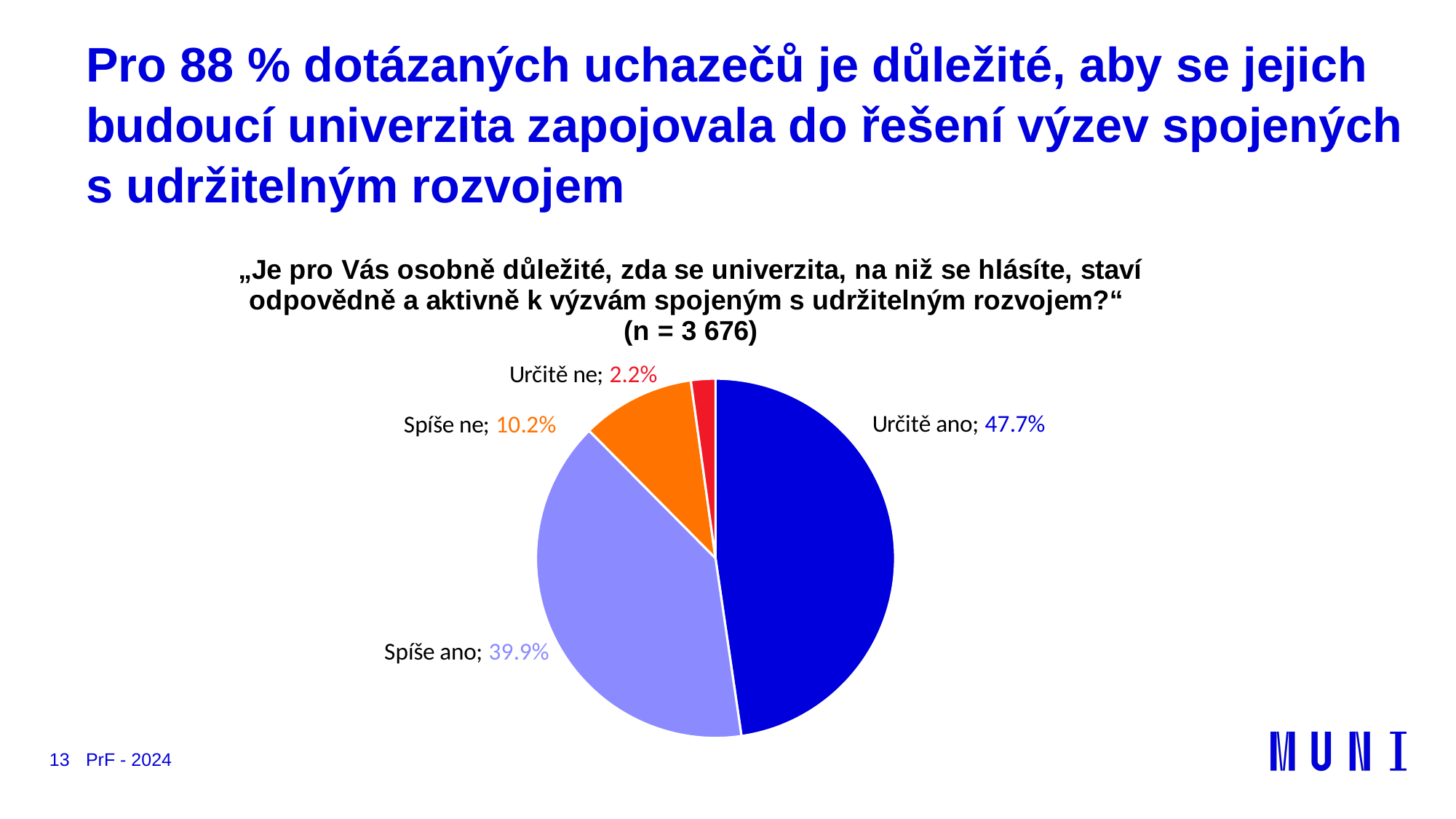
What percentage of respondents answered "Spíše ne"? 10.2% What percentage of respondents answered "Určitě ano"? 47.7% What is the difference in percentage points between "Určitě ano" and "Spíše ano"? 7.8 Which is larger, the share for "Spíše ne" or the share for "Určitě ne"? Spíše ne Which answer category has the largest share of the pie? Určitě ano What type of chart is shown on the slide? pie chart What percentage of respondents answered "Spíše ano"? 39.9% What is the sample size (n) stated in the chart title? 3 676 What percentage of respondents answered "Určitě ne"? 2.2% What is the combined share of "Určitě ano" and "Spíše ano"? 87.6% How many answer categories are shown in the pie chart? 4 Which answer category has the smallest share of the pie? Určitě ne